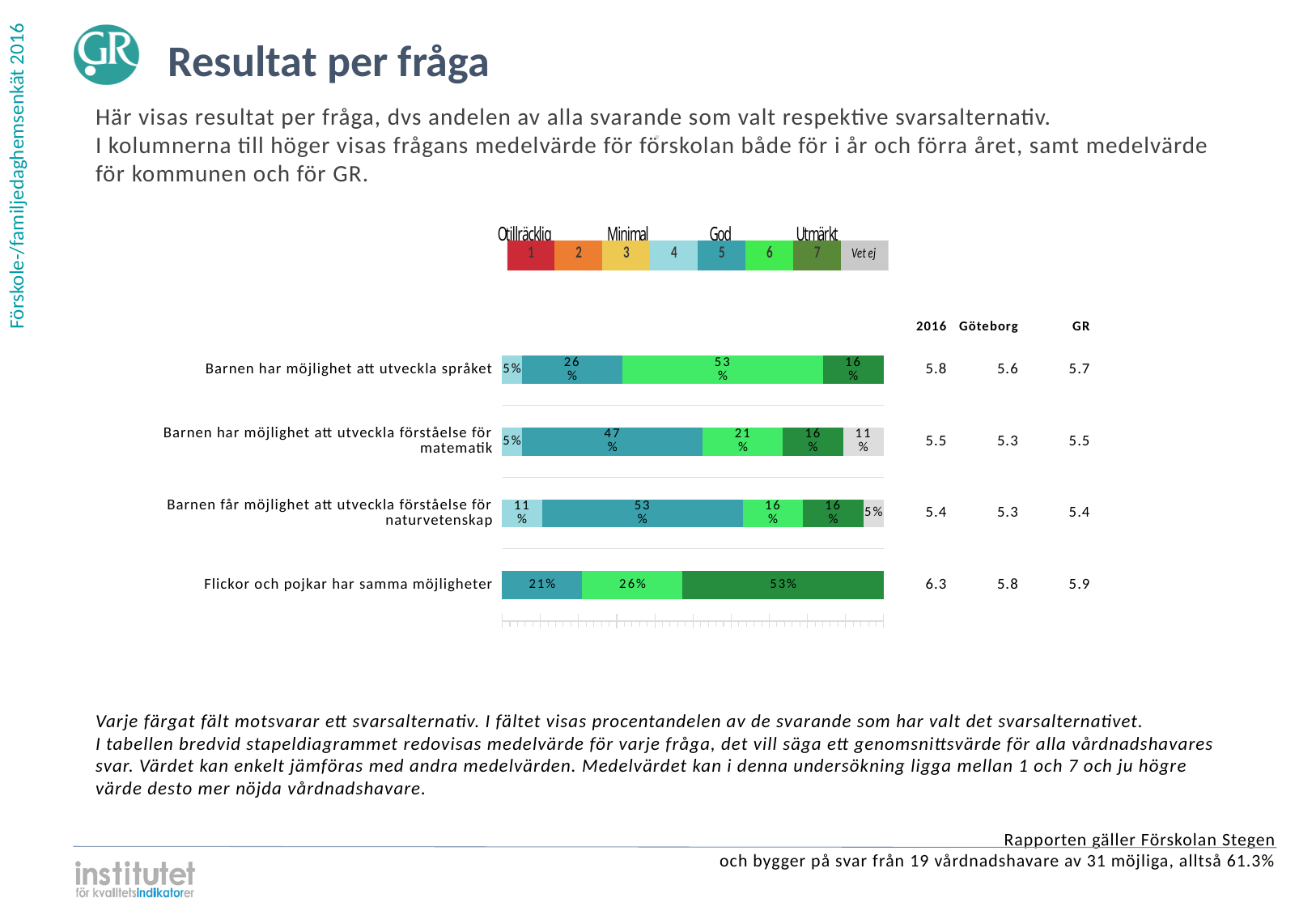
What is the difference between the share choosing alternative 5 and the share choosing alternative 6 for 'Barnen har möjlighet att utveckla förståelse för matematik'? 26% What kind of chart is used to show the results per question? stacked bar chart How many answer alternatives does the legend above the chart list? 8 What is the Göteborg mean value for 'Barnen har möjlighet att utveckla språket'? 5.6 What percentage of respondents chose alternative 6 for 'Barnen har möjlighet att utveckla språket'? 53% What percentage of respondents chose alternative 7 for 'Flickor och pojkar har samma möjligheter'? 53% What percentage of respondents answered 'Vet ej' for 'Barnen får möjlighet att utveckla förståelse för naturvetenskap'? 5% Which question has the largest share of respondents choosing alternative 7? Flickor och pojkar har samma möjligheter For 'Barnen får möjlighet att utveckla förståelse för naturvetenskap', which is larger: the share choosing alternative 4 or the share choosing alternative 5? alternative 5 How many questions (categories) are shown as bars in the chart? 4 What percentage of respondents chose alternative 5 for 'Barnen har möjlighet att utveckla förståelse för matematik'? 47% What is the 2016 mean value for 'Flickor och pojkar har samma möjligheter'? 6.3